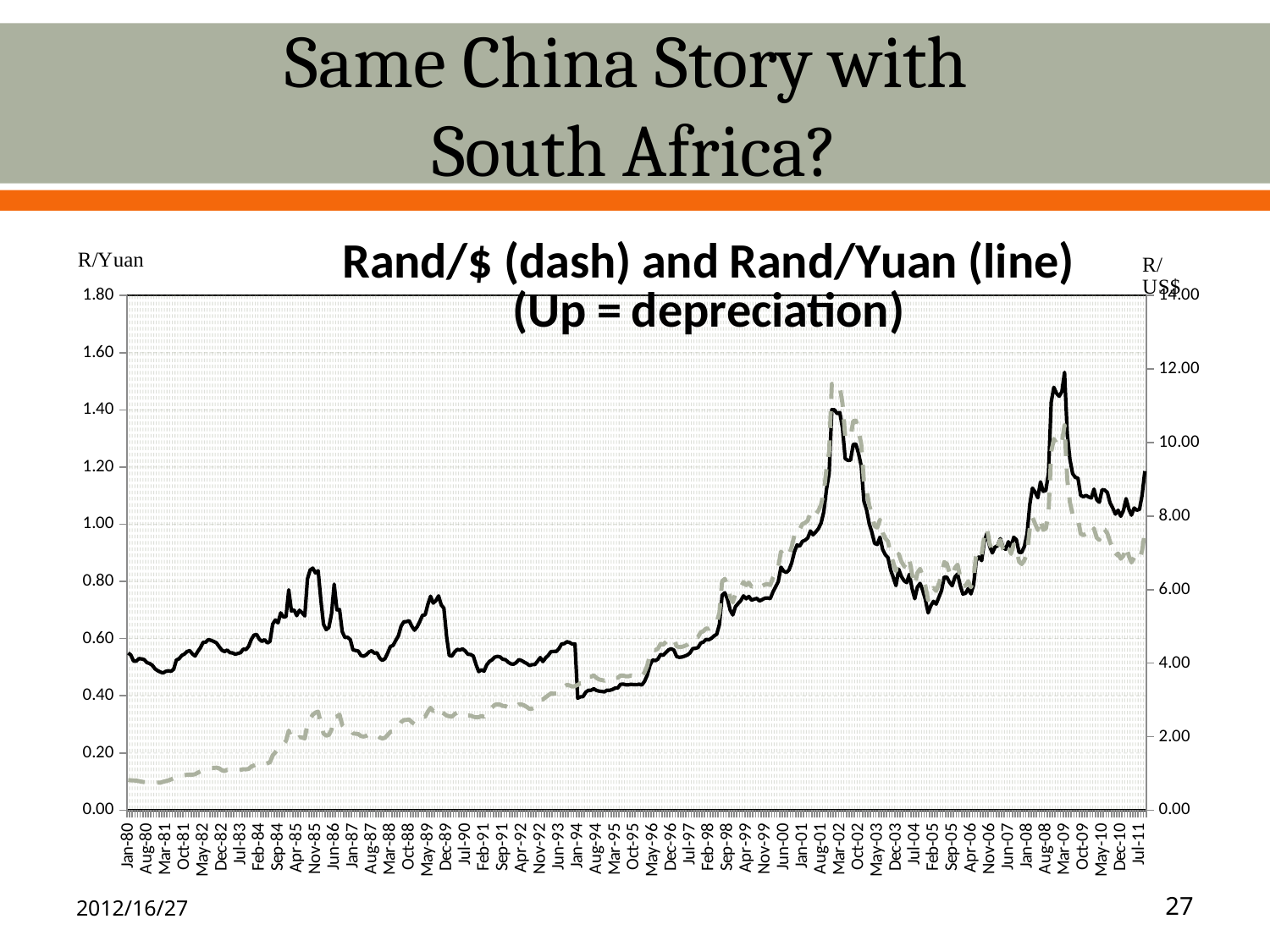
Is the Rand/Yuan value just after Jan-94 greater or less than 0.60 on the left axis? less Is the Rand/Yuan value at Jan-80 greater or less than 0.40 on the left axis? greater Does the Rand/Yuan series overall rise or fall from Jan-80 to Jul-11? rise Which series is drawn as a dashed line? Rand/$ How many series are plotted on the chart? 2 What kind of chart is shown on the slide? line chart Is the Rand/$ value at its peak around Mar-02 greater or less than 10.00 on the right axis? greater What is the title of the chart? Rand/$ (dash) and Rand/Yuan (line) (Up = depreciation) Does the Rand/$ series overall rise or fall from Jan-80 to Jul-11? rise